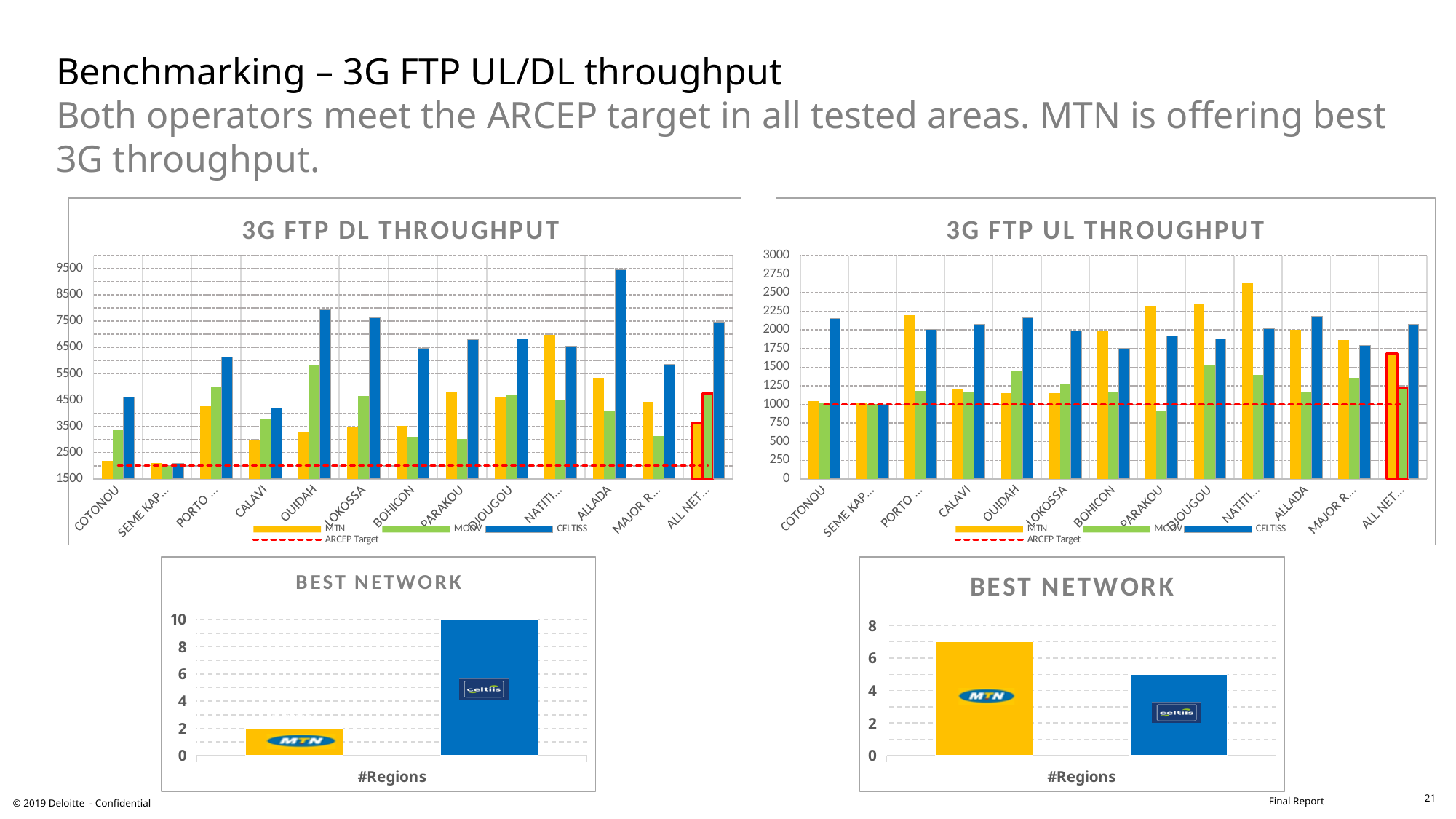
In the "3G FTP UL THROUGHPUT" chart, which is larger for PARAKOU, MTN or MOOV? MTN What kind of chart is the "3G FTP DL THROUGHPUT" chart? bar chart In the bottom-left "BEST NETWORK" chart, what is the difference between the Celtiis and MTN values? 8 What is the x-axis label of the bottom-right "BEST NETWORK" chart? #Regions In the "3G FTP DL THROUGHPUT" chart, is the CELTISS value for ALLADA greater or less than 8500? greater In the "3G FTP DL THROUGHPUT" chart, which series has the highest value for ALLADA? CELTISS In the bottom-left "BEST NETWORK" chart, what is the value for Celtiis? 10 How many categories are shown on the x axis of the "3G FTP DL THROUGHPUT" chart? 13 In the bottom-right "BEST NETWORK" chart, which operator has the higher bar? MTN In the "3G FTP UL THROUGHPUT" chart, is the MOOV value for COTONOU greater or less than 1500? less In the "3G FTP DL THROUGHPUT" chart, is the MTN value for COTONOU greater or less than 2500? less How many entries does the legend of the "3G FTP UL THROUGHPUT" chart list? 4